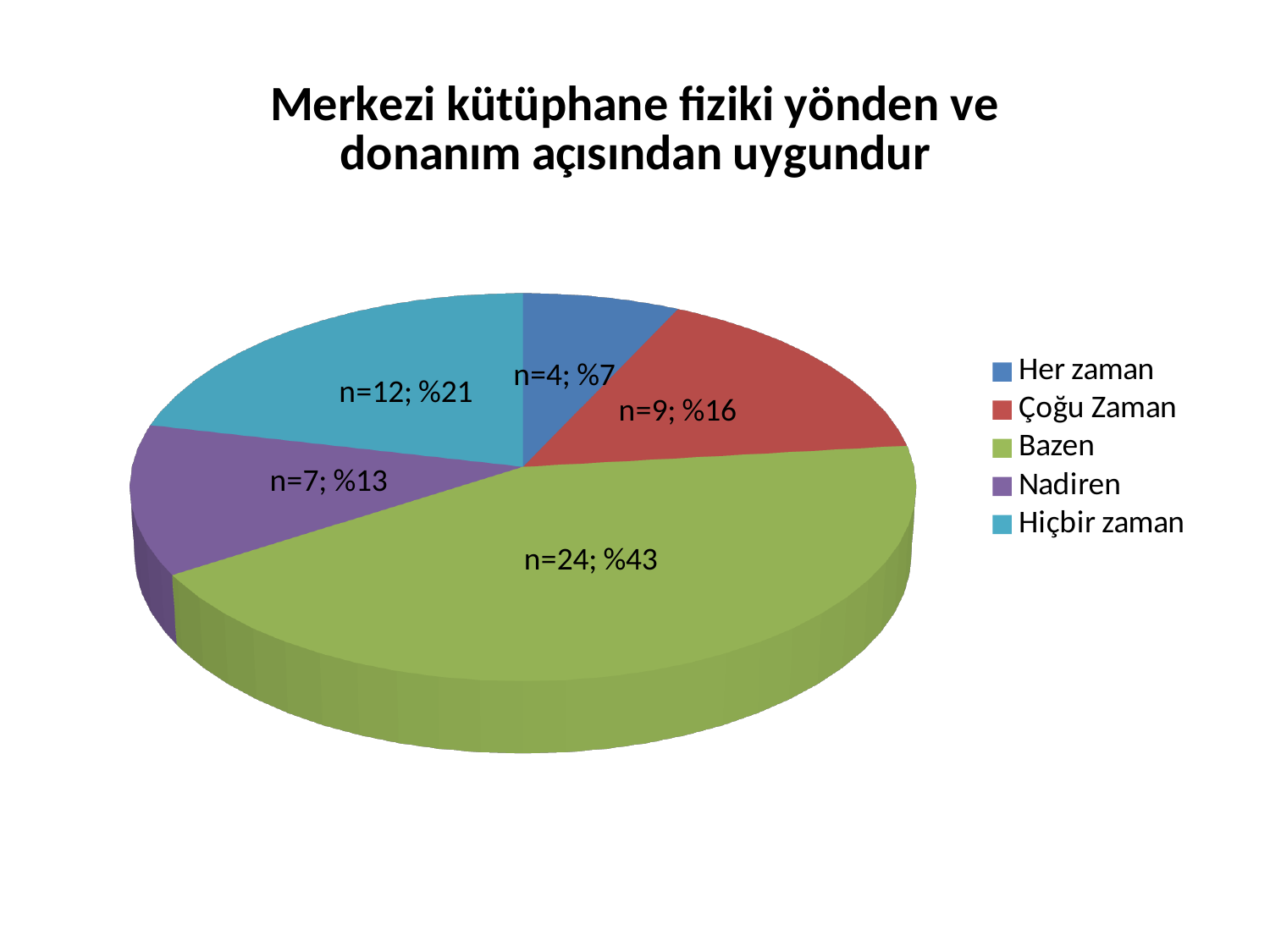
How many categories does the legend list? 5 What is the count (n) for the Her zaman slice? n=4 What is the difference in count between Çoğu Zaman and Nadiren? 2 What percentage share does the Bazen slice have? %43 Which category has the largest slice? Bazen What percentage share does the Hiçbir zaman slice have? %21 Which category has the smallest slice? Her zaman What is the count (n) for the Bazen slice? n=24 What kind of chart is shown on the slide? Pie chart Which is larger, the Hiçbir zaman slice or the Çoğu Zaman slice? Hiçbir zaman What is the title of the chart? Merkezi kütüphane fiziki yönden ve donanım açısından uygundur What is the total count (n) across all slices? 56